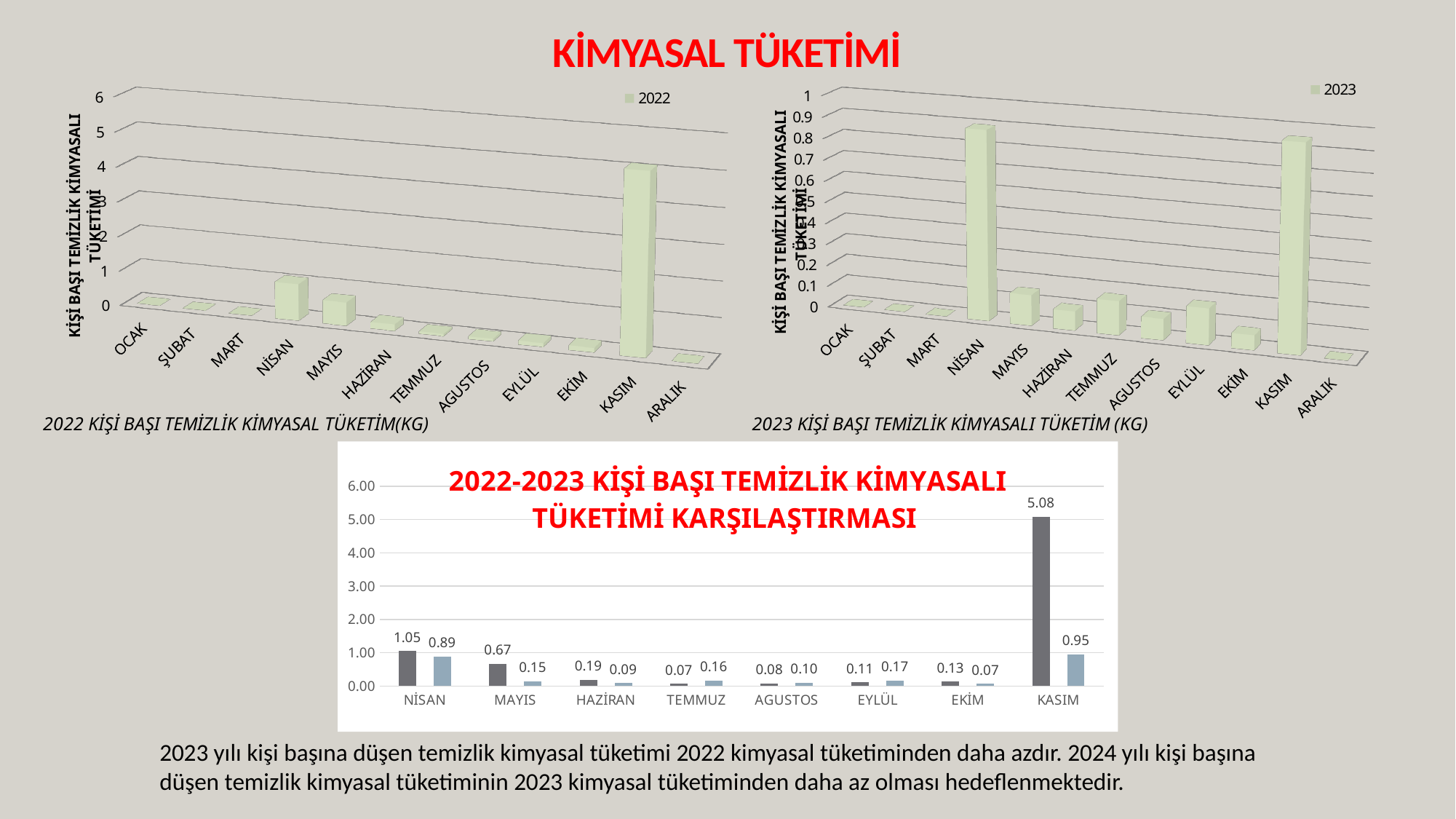
In the bottom comparison chart, for TEMMUZ, which bar is larger: the dark grey bar or the light blue bar? the light blue bar In the bottom chart titled '2022-2023 KİŞİ BAŞI TEMİZLİK KİMYASALI TÜKETİMİ KARŞILAŞTIRMASI', what is the value of the dark grey bar for KASIM? 5.08 In the top-right chart (2023 KİŞİ BAŞI TEMİZLİK KİMYASALI TÜKETİM (KG)), is the value for NİSAN greater or less than 0.5? greater What kind of chart is the top-left chart (2022 KİŞİ BAŞI TEMİZLİK KİMYASAL TÜKETİM(KG))? bar chart In the bottom comparison chart, what is the difference between the dark grey bar and the light blue bar for KASIM? 4.13 How many months are shown on the x axis of the top-left chart (2022 KİŞİ BAŞI TEMİZLİK KİMYASAL TÜKETİM(KG))? 12 How many months are shown on the x axis of the bottom comparison chart? 8 In the bottom comparison chart, what is the value of the light blue bar for NİSAN? 0.89 In the top-left chart (2022 KİŞİ BAŞI TEMİZLİK KİMYASAL TÜKETİM(KG)), which month has the highest bar? KASIM In the bottom comparison chart, which month has the highest dark grey bar? KASIM What entry does the legend of the top-right chart show? 2023 In the bottom comparison chart, what is the value of the light blue bar for EKİM? 0.07